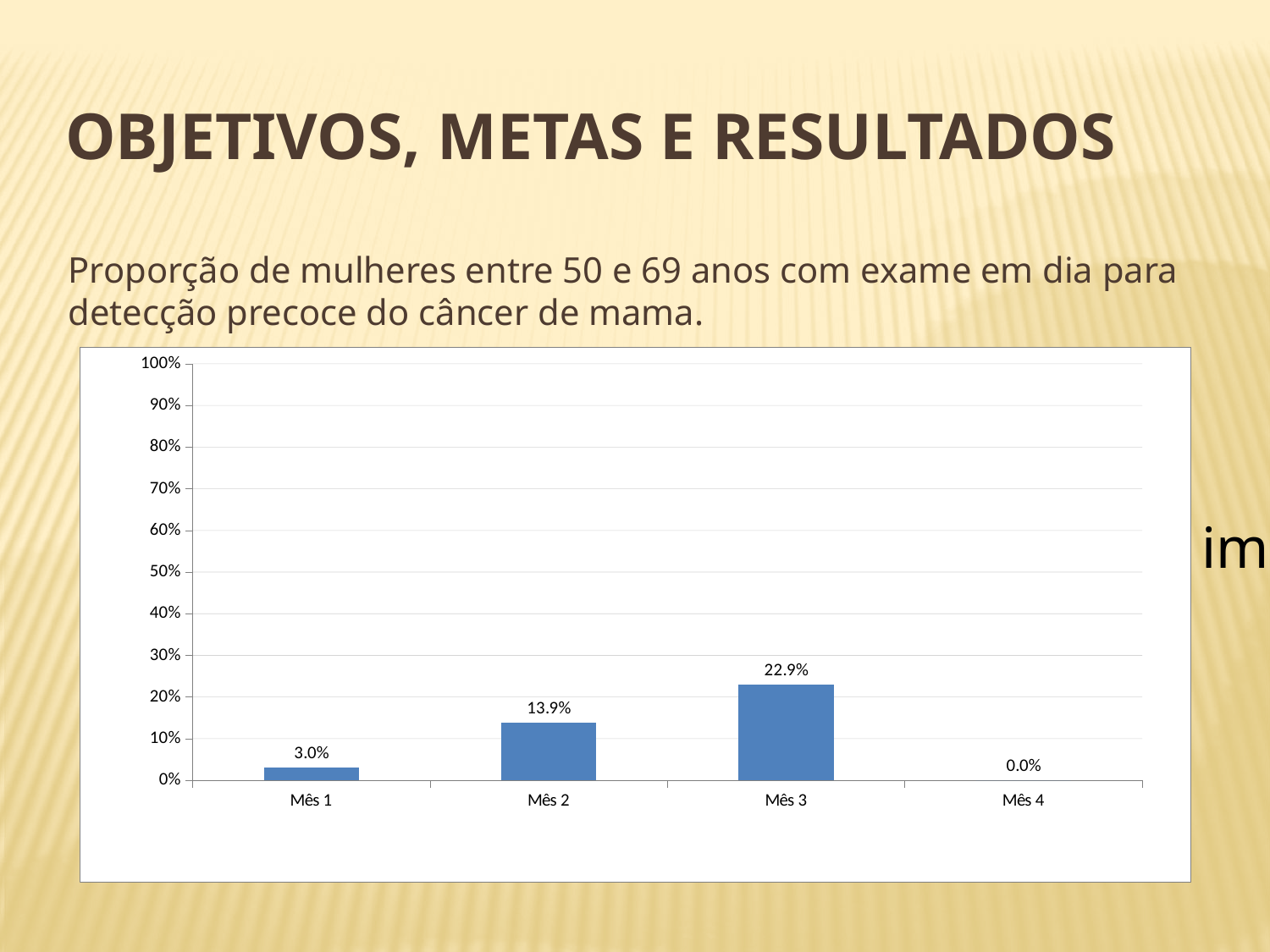
What is the value for Mês 1? 3.0% How many months are shown on the x axis? 4 What is the maximum value shown on the y axis? 100% Is the value for Mês 3 greater or less than 30%? less Which month has the highest value? Mês 3 What kind of chart is shown on the slide? bar chart What is the value for Mês 2? 13.9% What is the difference between the values for Mês 3 and Mês 2? 9.0% Which month has the lowest value? Mês 4 Which is larger, the value for Mês 2 or the value for Mês 1? Mês 2 What is the value for Mês 4? 0.0% What is the value for Mês 3? 22.9%